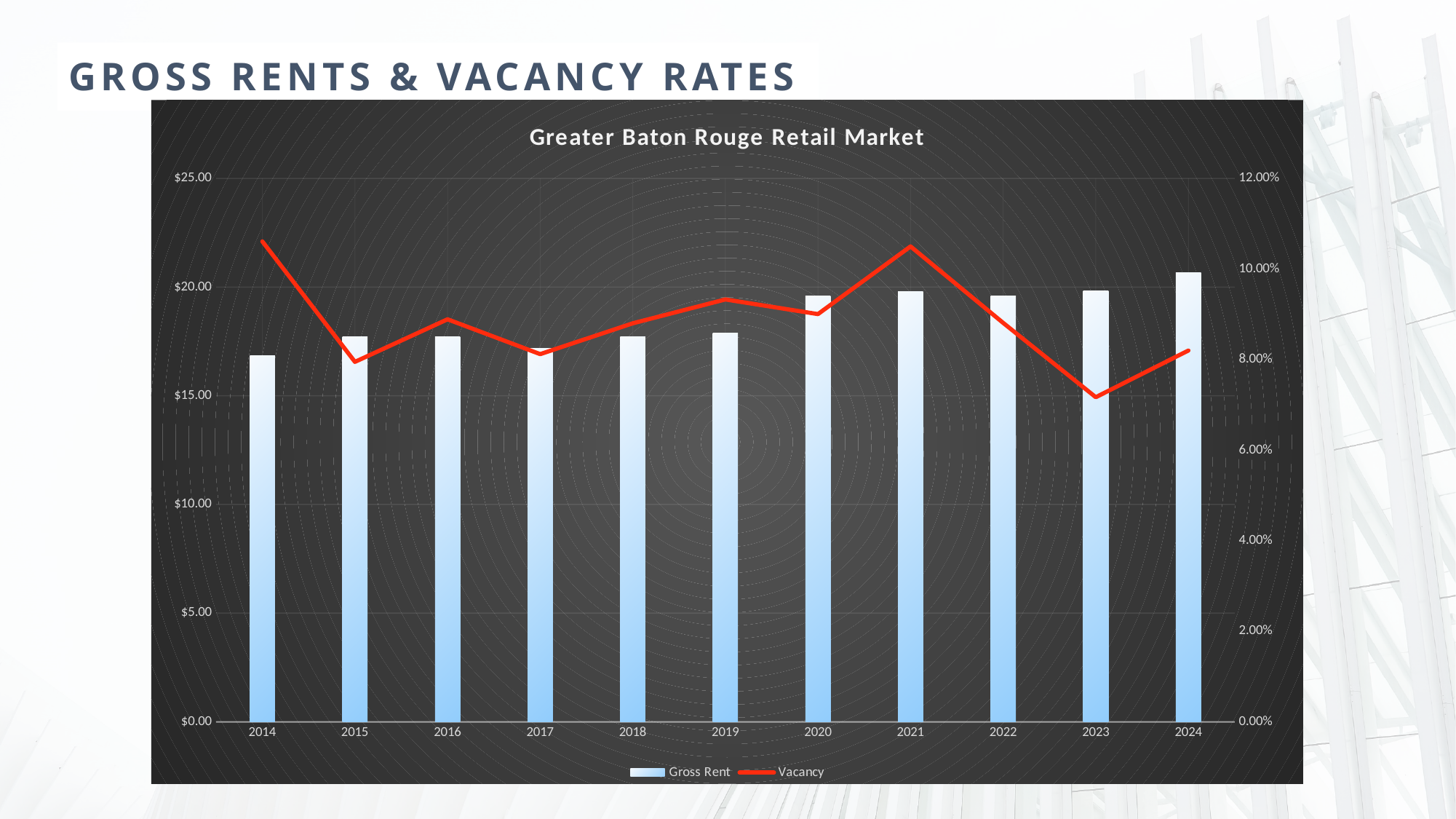
Which year has the lowest Gross Rent bar? 2014 Is the Gross Rent for 2024 greater or less than $20.00? greater What is the title of the chart? Greater Baton Rouge Retail Market How many years are shown on the x axis? 11 Which year has the highest Gross Rent bar? 2024 Is the Gross Rent for 2014 greater or less than $20.00? less Is the Vacancy rate for 2023 greater or less than 8.00%? less Which year has the larger Vacancy rate, 2021 or 2023? 2021 Does Gross Rent generally rise or fall from 2014 to 2024? rise Which year has the lowest Vacancy rate? 2023 What kind of chart is used to show Gross Rent? Bar chart How many series does the legend list? 2